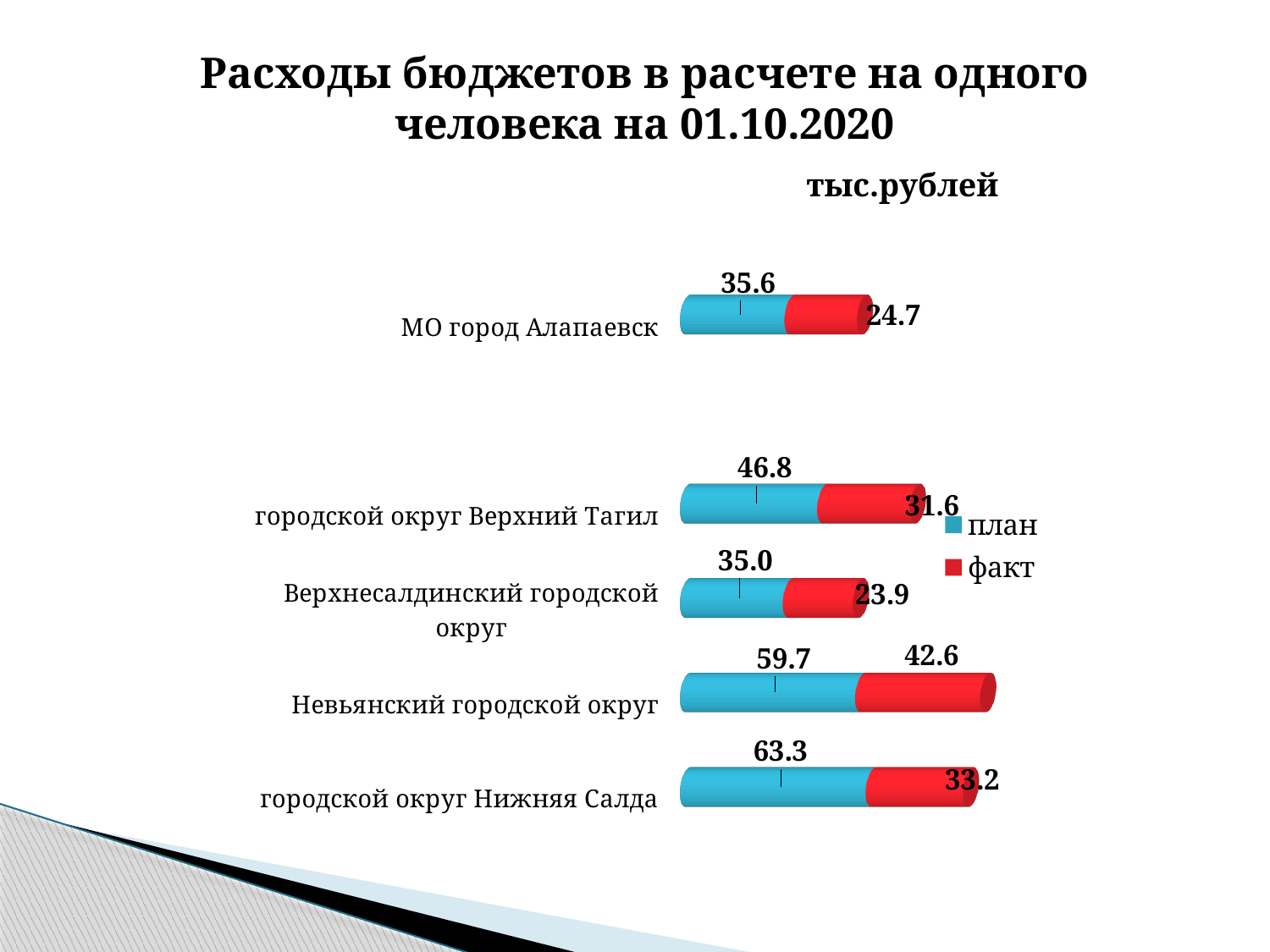
What is the план value for Верхнесалдинский городской округ? 35.0 Which category has the lowest факт value? Верхнесалдинский городской округ Which category has the highest факт value? Невьянский городской округ What is the план value for Невьянский городской округ? 59.7 What is the difference between the план and факт values for городской округ Верхний Тагил? 15.2 What is the total of the план and факт values for Невьянский городской округ? 102.3 What is the факт value for МО город Алапаевск? 24.7 How many series does the legend list? 2 What kind of chart is shown on the slide? Bar chart Which category has the highest план value? городской округ Нижняя Салда What is the факт value for городской округ Нижняя Салда? 33.2 Which is larger: the план value for Невьянский городской округ or the план value for городской округ Верхний Тагил? Невьянский городской округ